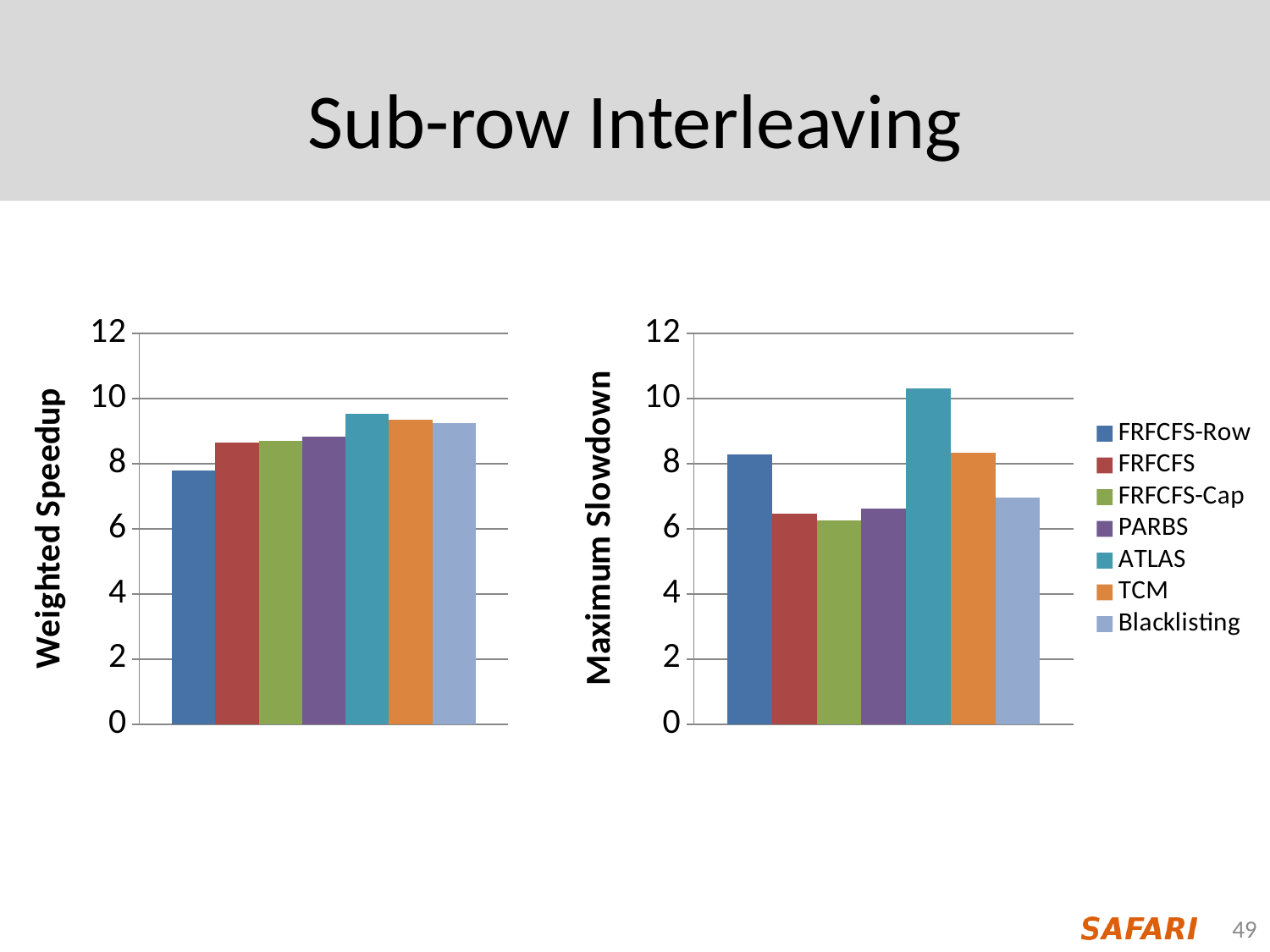
In the Maximum Slowdown chart on the right, is the value for Blacklisting greater or less than 8? less How many bars are plotted in the Maximum Slowdown chart on the right? 7 In the Maximum Slowdown chart on the right, which is larger, the value for FRFCFS-Row or the value for Blacklisting? FRFCFS-Row In the Weighted Speedup chart on the left, which series has the lowest value? FRFCFS-Row In the Maximum Slowdown chart on the right, which series has the highest value? ATLAS In the Weighted Speedup chart on the left, which series has the highest value? ATLAS In the Maximum Slowdown chart on the right, is the value for ATLAS greater or less than 10? greater What kind of chart is the Weighted Speedup chart on the left? bar chart In the Maximum Slowdown chart on the right, is the value for FRFCFS-Row greater or less than 8? greater How many series does the legend list? 7 What is the y-axis label of the chart on the left? Weighted Speedup